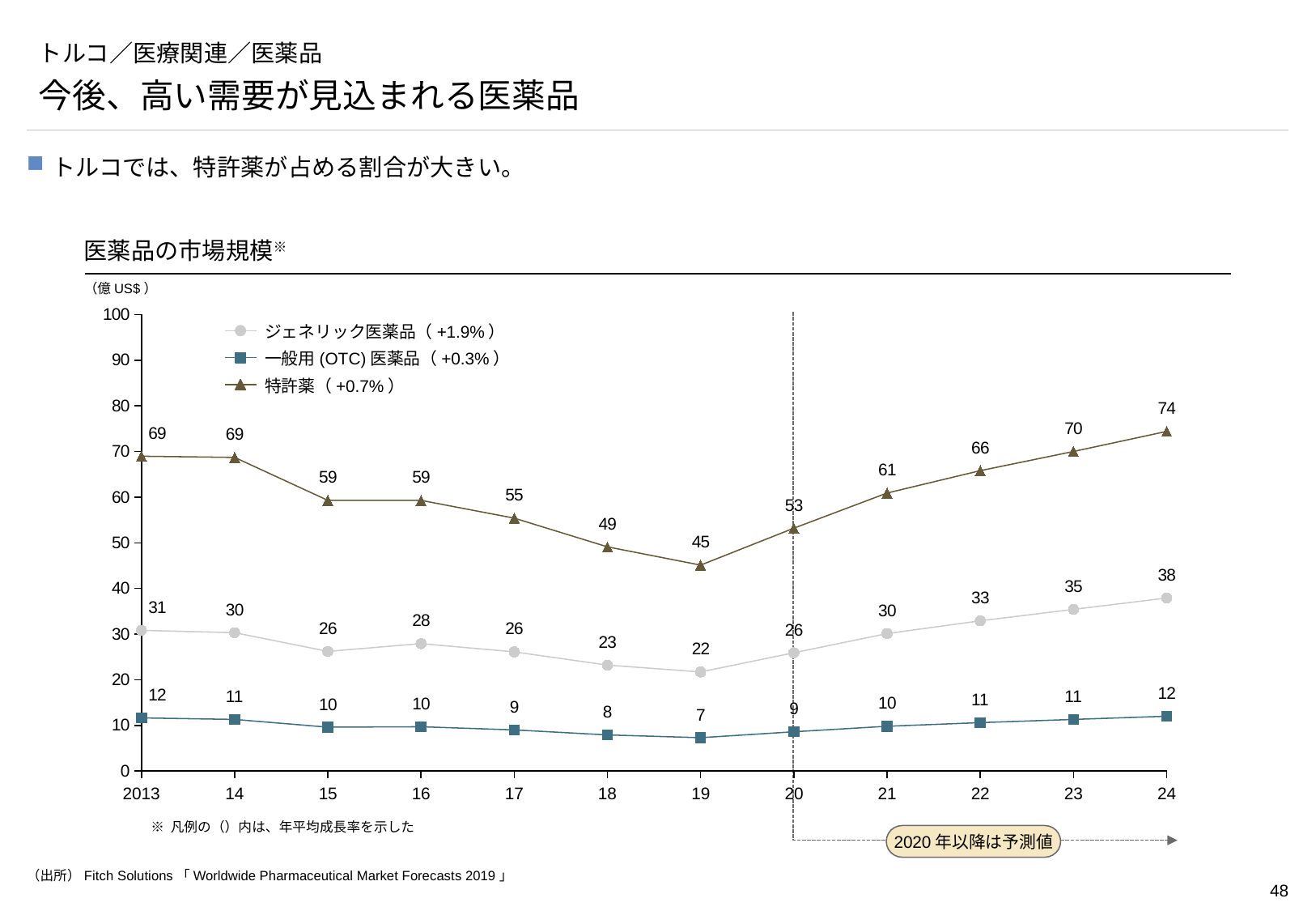
In which year is the value for ジェネリック医薬品 highest? 24 Does the value for 特許薬 rise or fall from 2013 to 19? fall What is the value for 一般用(OTC)医薬品 in 24? 12 Which is larger in 2013: the value for ジェネリック医薬品 or the value for 一般用(OTC)医薬品? ジェネリック医薬品 How many series does the legend list? 3 What type of chart is shown on the slide? line chart What is the difference between the 特許薬 value in 24 and in 19? 29 What is the value for ジェネリック医薬品 in 19? 22 In which year is the value for 特許薬 lowest? 19 What is the value for 特許薬 in 2013? 69 How many years are plotted on the x axis? 12 What is the title of the chart? 医薬品の市場規模